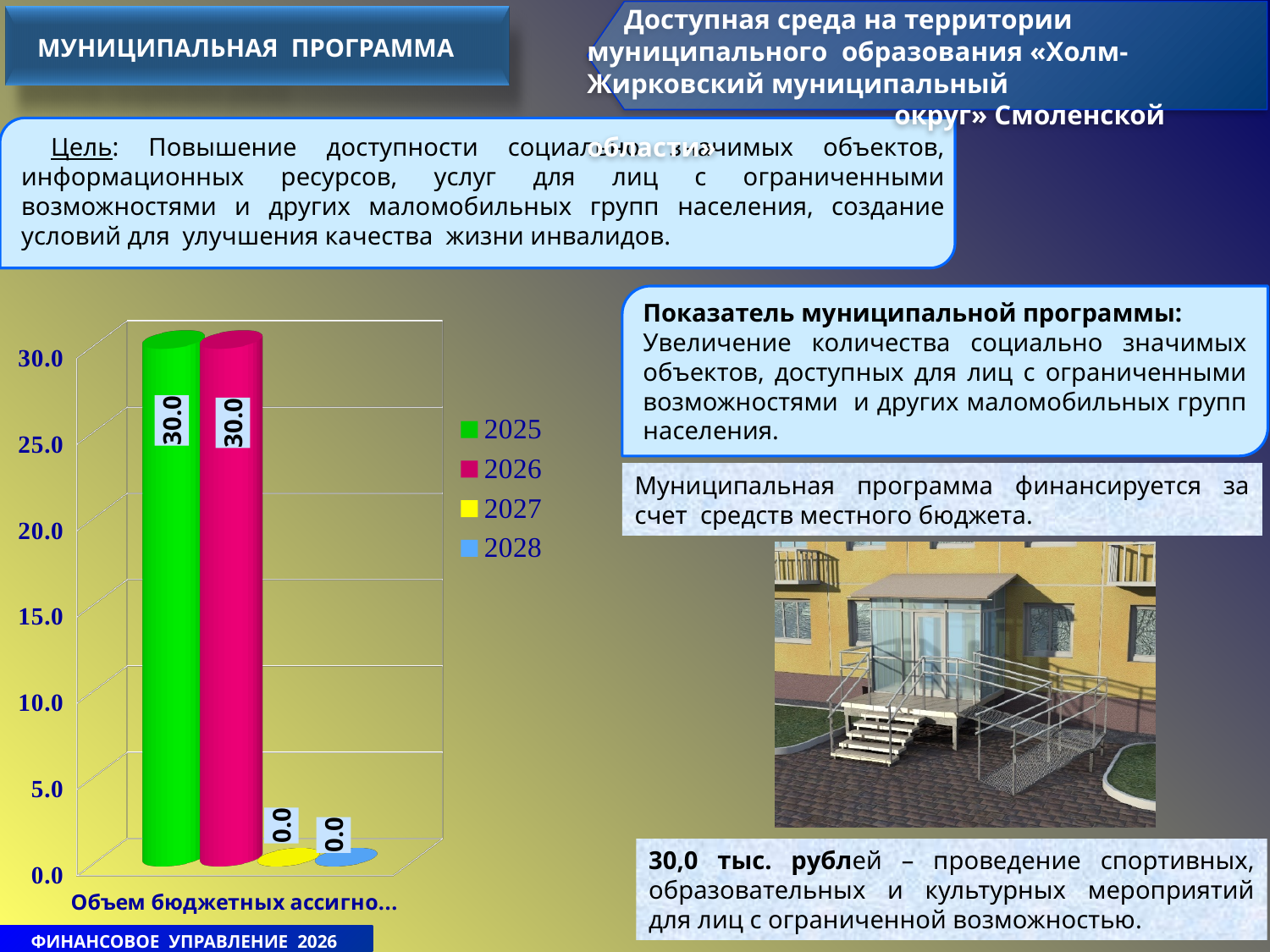
Which is larger in the chart, the value for 2026 or the value for 2028? 2026 Is the value for 2027 in the chart greater or less than 5.0? less What is the total of the values for 2025 and 2026 in the chart? 60.0 Is the value for 2025 in the chart greater or less than 25.0? greater What is the difference between the values for 2025 and 2027 in the chart? 30.0 What is the value for the 2027 series in the chart? 0.0 What is the value for the 2025 series in the chart? 30.0 What kind of chart is shown on the slide? bar chart What colour is the bar for the 2026 series in the chart? pink (magenta) What is the value for the 2026 series in the chart? 30.0 What is the value for the 2028 series in the chart? 0.0 How many series does the chart legend list? 4